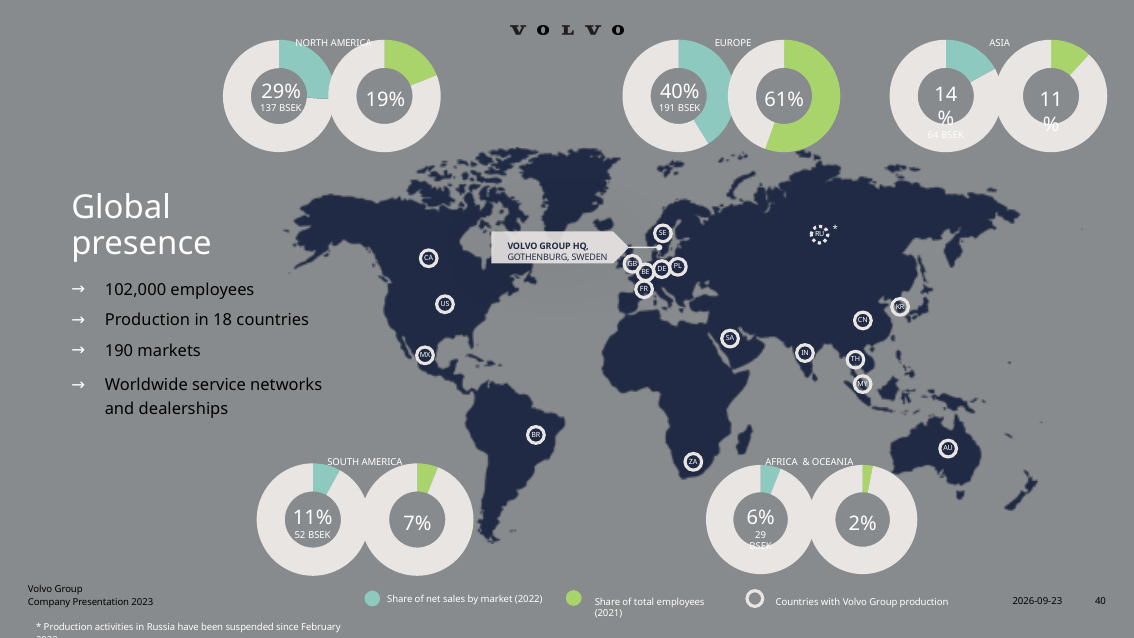
What is the difference between Europe's share of total employees (61%) and North America's share of total employees (19%)? 42 percentage points In the Africa & Oceania donut charts, what net sales value in BSEK is shown? 29 BSEK In the Europe donut charts, what is the share of net sales by market (2022)? 40% Across the regional donut charts, which region has the lowest share of total employees (2021)? Africa & Oceania In the North America donut charts, what net sales value in BSEK is shown? 137 BSEK In the Asia donut charts, what is the share of net sales by market (2022)? 14% Which is larger: Asia's share of net sales by market (2022) or South America's share of net sales by market (2022)? Asia What type of chart is used to show the regional shares on this slide? Donut (pie) chart In the South America donut charts, what is the share of total employees (2021)? 7% In the Europe donut charts, what is the share of total employees (2021)? 61% According to the legend, what does the green colour in the donut charts represent? Share of total employees (2021) Across the regional donut charts, which region has the highest share of net sales by market (2022)? Europe